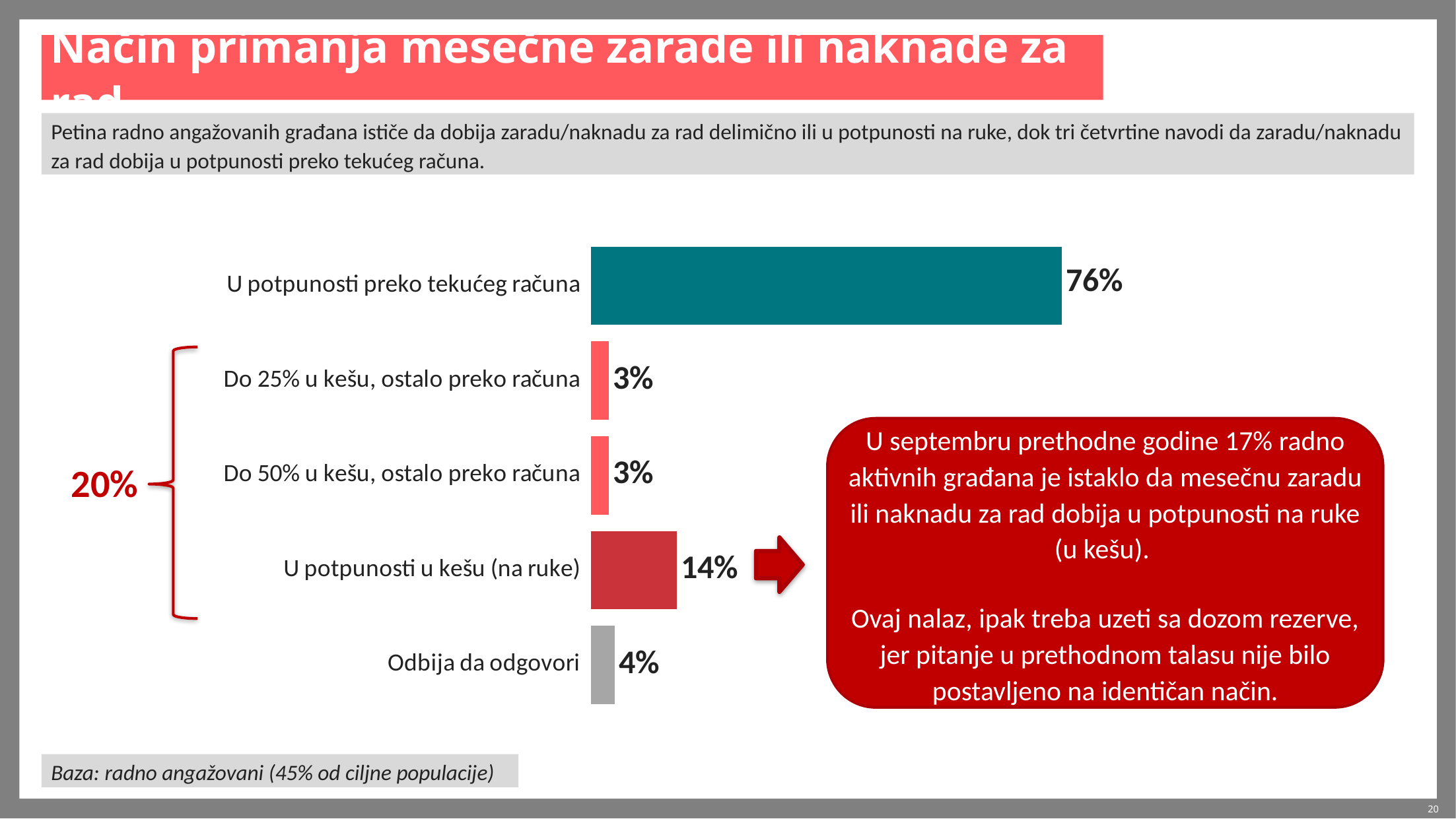
Which is larger, the value for "U potpunosti u kešu (na ruke)" or the value for "Odbija da odgovori"? U potpunosti u kešu (na ruke) What is the value for "U potpunosti preko tekućeg računa"? 76% What colour is the bar for "U potpunosti preko tekućeg računa"? Teal Which category has the highest value? U potpunosti preko tekućeg računa What is the value for "U potpunosti u kešu (na ruke)"? 14% What is the combined share shown by the red bracket for the three categories involving cash (kešu)? 20% What is the difference between the values for "U potpunosti u kešu (na ruke)" and "Odbija da odgovori"? 10% What kind of chart is shown on the slide? Bar chart What is the value for "Do 25% u kešu, ostalo preko računa"? 3% What is the value for "Odbija da odgovori"? 4% What is the difference between the values for "U potpunosti preko tekućeg računa" and "U potpunosti u kešu (na ruke)"? 62% How many categories are shown in the bar chart? 5